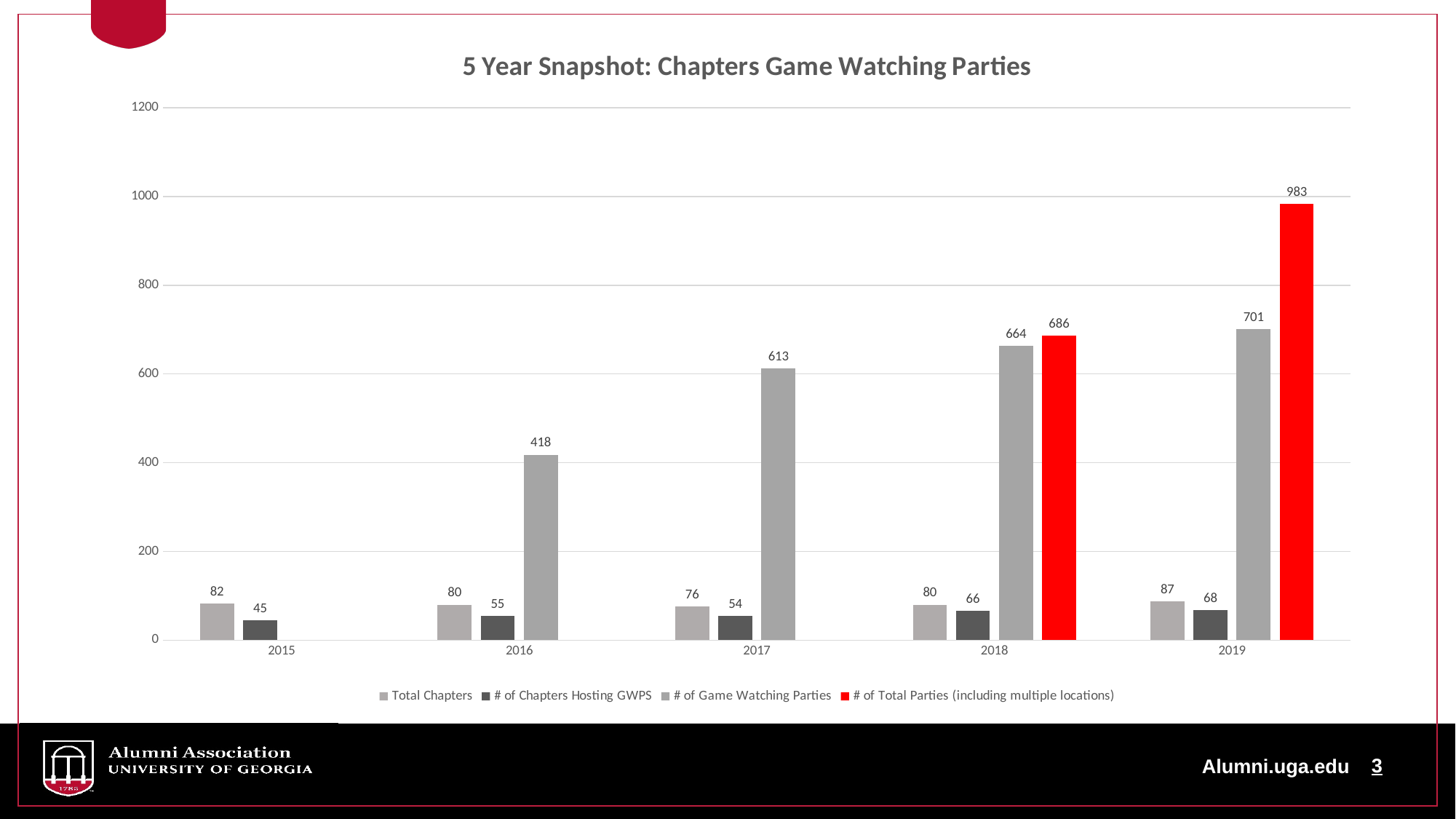
What is the difference between # of Total Parties and # of Game Watching Parties in 2019? 282 Which year has the highest value for # of Chapters Hosting GWPS? 2019 Which is larger in 2018: # of Game Watching Parties or # of Total Parties (including multiple locations)? # of Total Parties (including multiple locations) Which year has the lowest value for # of Game Watching Parties? 2016 How many series does the legend list? 4 What is the value of # of Total Parties (including multiple locations) in 2019? 983 How many years are shown on the x axis? 5 What is the title of the chart? 5 Year Snapshot: Chapters Game Watching Parties Does the value for # of Game Watching Parties rise or fall from 2016 to 2019? Rise What kind of chart is shown on the slide? Bar chart What is the value of # of Game Watching Parties in 2017? 613 What is the value of Total Chapters in 2015? 82